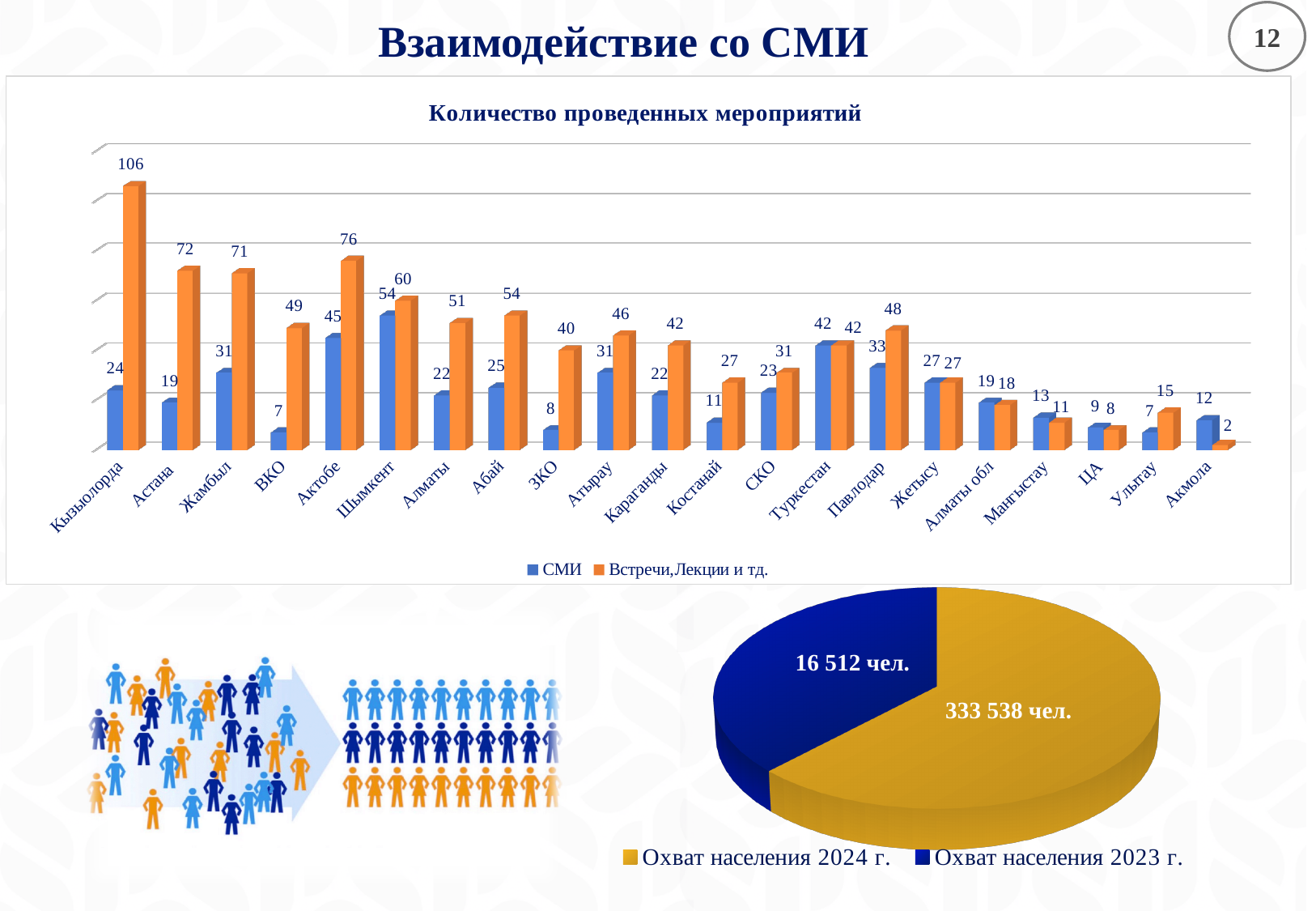
In the bar chart 'Количество проведенных мероприятий', which is larger for Акмола: 'СМИ' or 'Встречи,Лекции и тд.'? СМИ In the bar chart 'Количество проведенных мероприятий', what is the value of 'СМИ' for Туркестан? 42 In the bar chart 'Количество проведенных мероприятий', which category has the lowest value for 'Встречи,Лекции и тд.'? Акмола How many series does the legend of the bar chart 'Количество проведенных мероприятий' list? 2 In the bar chart 'Количество проведенных мероприятий', which category has the highest value for 'Встречи,Лекции и тд.'? Кызыолорда In the bar chart 'Количество проведенных мероприятий', what is the value of 'Встречи,Лекции и тд.' for Кызылорда? 106 In the bar chart 'Количество проведенных мероприятий', what is the value of 'СМИ' for Шымкент? 54 How many categories are shown on the x axis of the bar chart 'Количество проведенных мероприятий'? 21 In the pie chart at the bottom right, which slice is larger: 'Охват населения 2024 г.' or 'Охват населения 2023 г.'? Охват населения 2024 г. In the bar chart 'Количество проведенных мероприятий', what is the difference between the 'Встречи,Лекции и тд.' and 'СМИ' values for Астана? 53 What kind of chart is 'Количество проведенных мероприятий'? Bar chart In the pie chart at the bottom right, what is the value for 'Охват населения 2023 г.'? 16 512 чел.